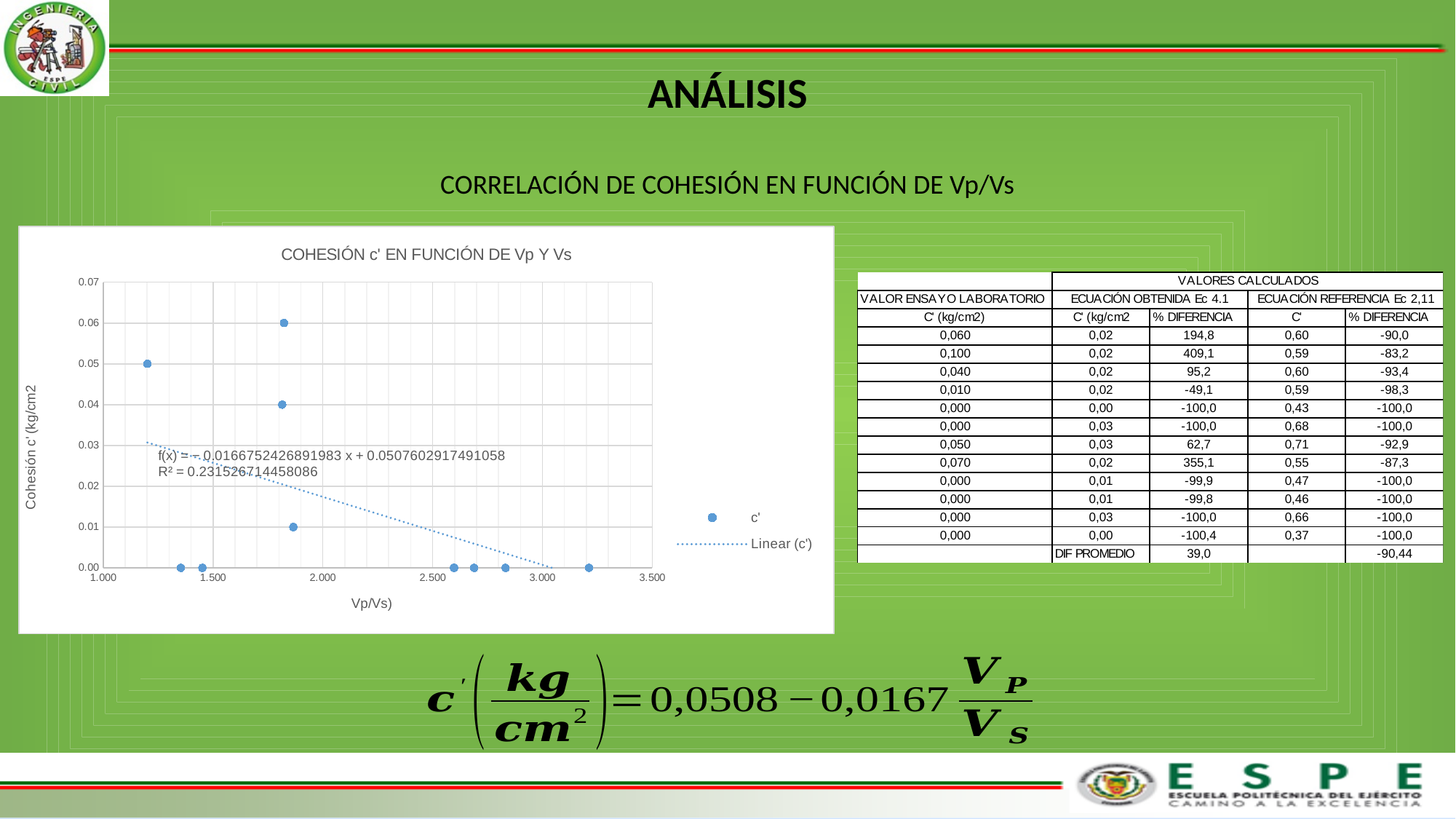
Is the highest plotted c' value in the chart greater or less than 0.05? greater Is the c' value of the point plotted at about Vp/Vs = 1.2 greater or less than 0.04? greater Is the c' value of the point plotted at about Vp/Vs = 3.2 greater or less than 0.01? less What is the highest value shown on the x axis of the chart? 3.500 What is the highest value shown on the y axis of the chart? 0.07 Does the linear trendline in the chart rise or fall as Vp/Vs increases? fall What is the title of the chart? COHESIÓN c' EN FUNCIÓN DE Vp Y Vs How many entries does the chart legend list? 2 What R² value is printed on the chart? 0.231526714458086 What is the label of the x axis of the chart? Vp/Vs) What kind of chart is shown on the slide? scatter chart